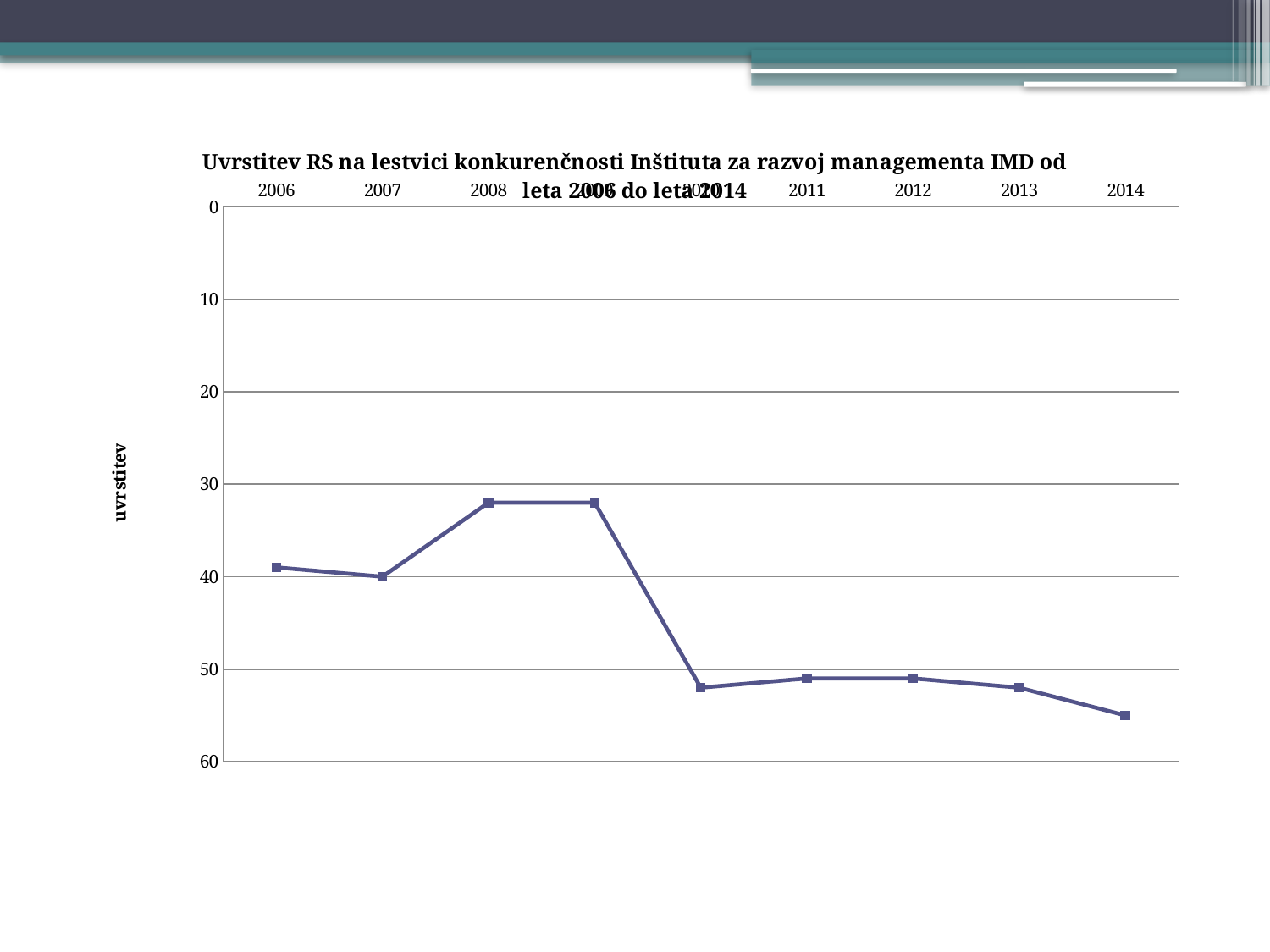
Which has the larger numeric value, 2007 or 2013? 2013 Do the numeric values rise or fall from 2011 to 2014? rise How many data points are plotted on the line? 9 Is the value for 2008 greater or less than 40? less Which year has the largest numeric value on the chart? 2014 Which has the larger numeric value, 2008 or 2014? 2014 What is the plotted value for 2007? 40 Is the value for 2006 greater or less than 30? greater Is the value for 2014 greater or less than 50? greater What is the label on the vertical axis? uvrstitev What kind of chart is shown on the slide? line chart